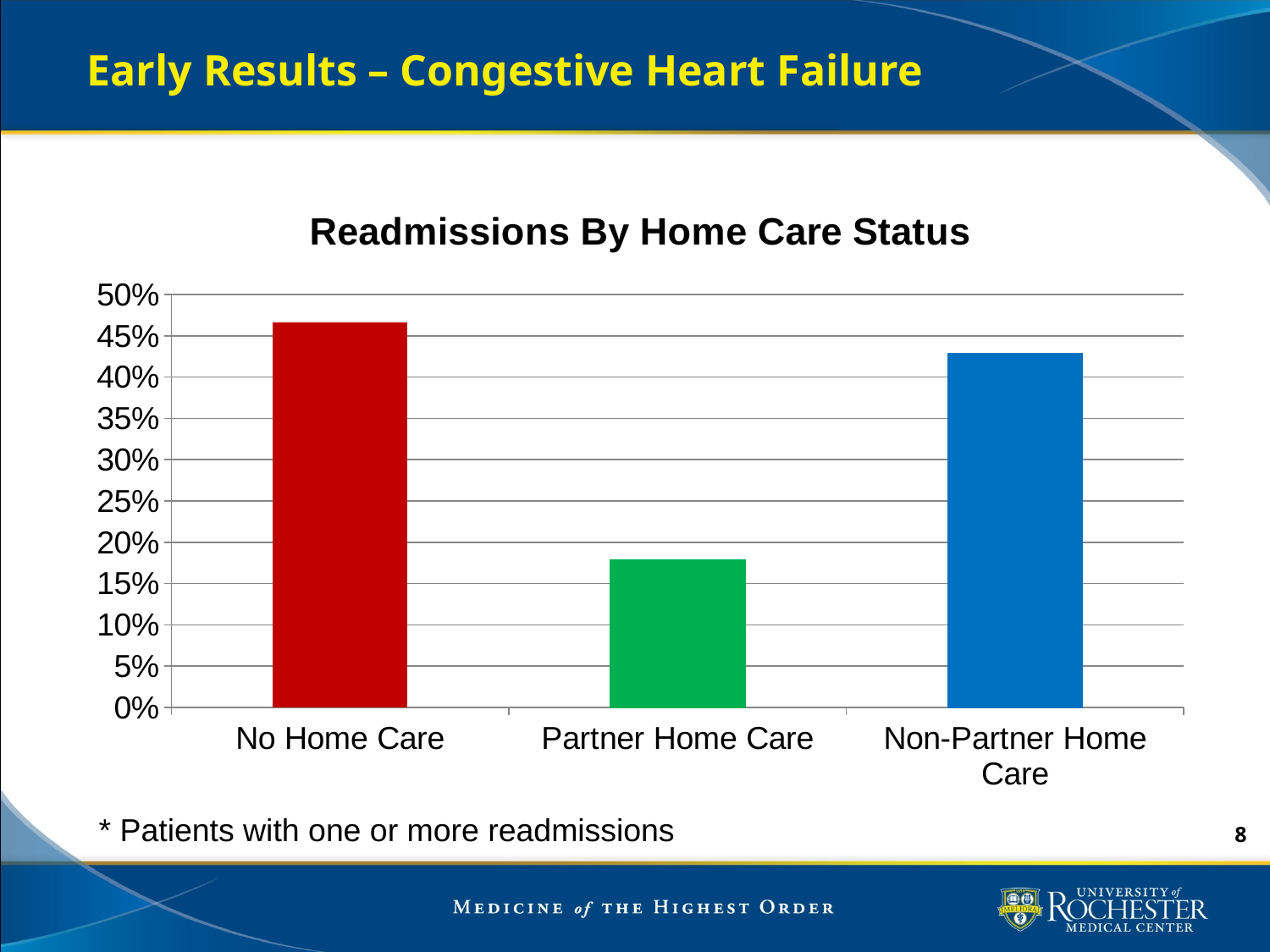
Which category has the highest readmission rate? No Home Care Which is larger, the value for No Home Care or the value for Non-Partner Home Care? No Home Care Which is larger, the value for Partner Home Care or the value for Non-Partner Home Care? Non-Partner Home Care What type of chart is shown on the slide? bar chart Which category has the lowest readmission rate? Partner Home Care How many categories are shown on the x axis of the chart? 3 Is the value for Partner Home Care greater or less than 20%? less What colour is the bar for Partner Home Care? green What is the title of the chart? Readmissions By Home Care Status Is the value for No Home Care greater or less than 45%? greater Is the value for Partner Home Care greater or less than 15%? greater